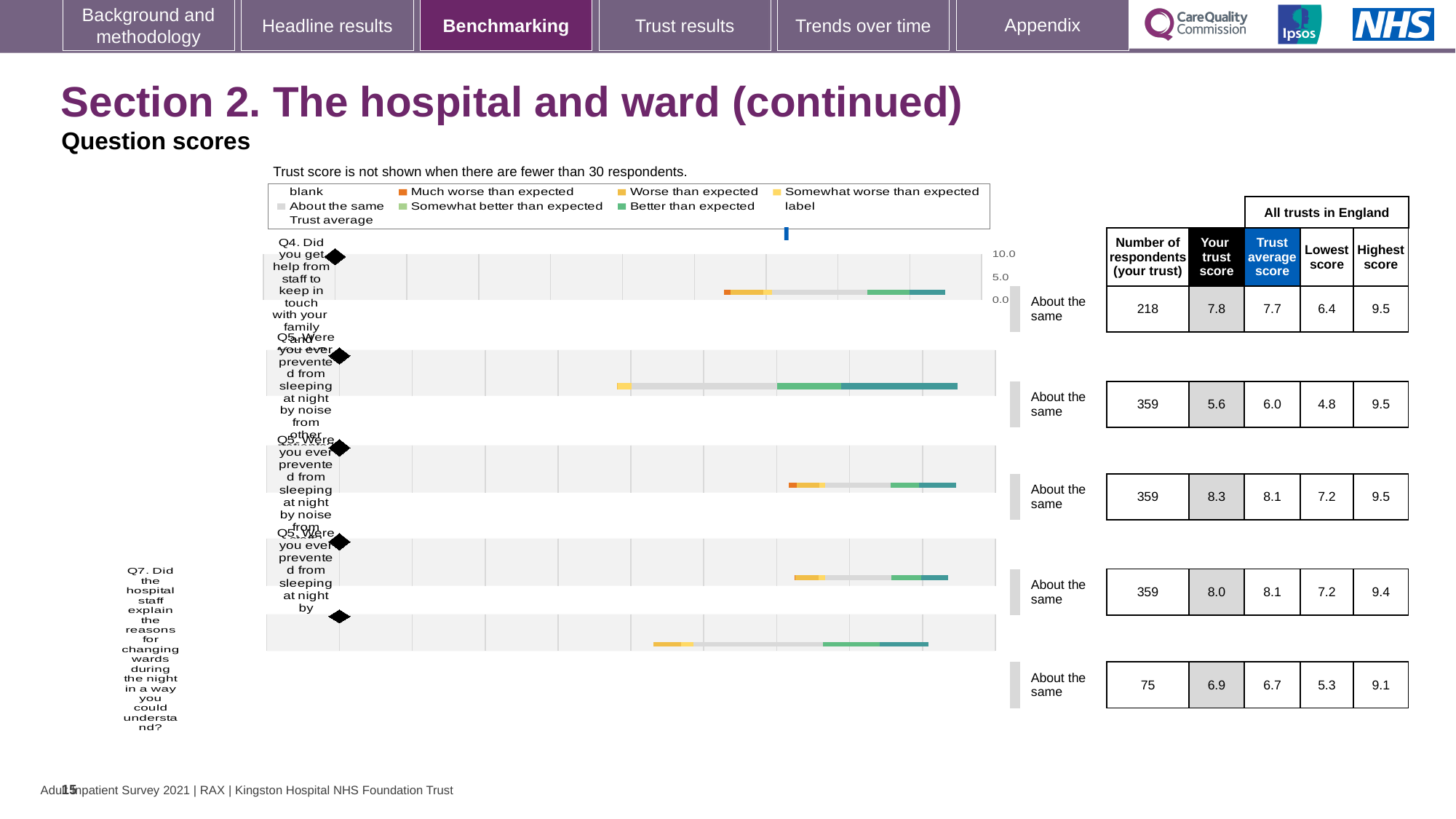
What is the trust average score for Q7 (the last row)? 6.7 What is the lowest 'Your trust score' value shown in the table? 5.6 How many question rows (bars) are plotted in the chart? 5 According to the note above the chart, when is the trust score not shown? When there are fewer than 30 respondents For Q4 (the first row), which is larger: your trust score or the trust average score? Your trust score What benchmark label is shown next to the Q4 row? About the same What kind of chart is used to show the question scores on this slide? bar chart What is the 'Your trust score' for Q4 (the first row)? 7.8 How many respondents does the table show for Q4 (the first row)? 218 Which question row has the fewest respondents? Q7 For Q7 (the last row), what is the difference between the highest score and the lowest score? 3.8 What is the highest score in England for Q7 (the last row)? 9.1